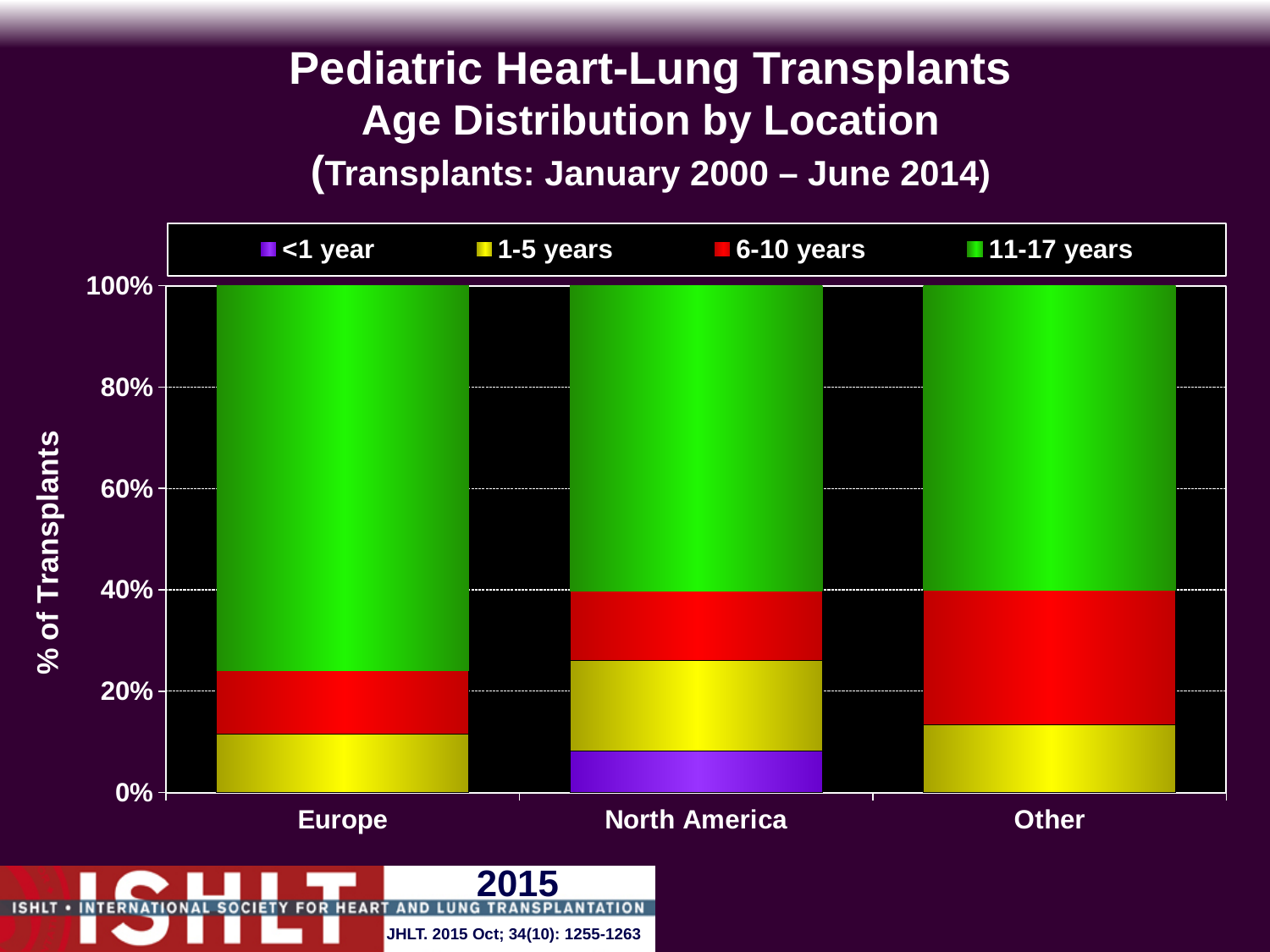
What kind of chart is shown on the slide? Stacked bar chart Is the share of 6-10 years transplants for Other greater or less than 20%? greater Which location has the largest share of transplants in the 6-10 years age group? Other Which location has the largest share of transplants in the 11-17 years age group? Europe Is the share of <1 year transplants for North America greater or less than 20%? less Is the share of 1-5 years transplants for Europe greater or less than 20%? less How many locations are shown on the x axis? 3 Which location is the only one with a visible <1 year segment? North America What is the label of the y axis? % of Transplants What is the total height of each stacked bar on the y axis? 100% How many age groups does the legend list? 4